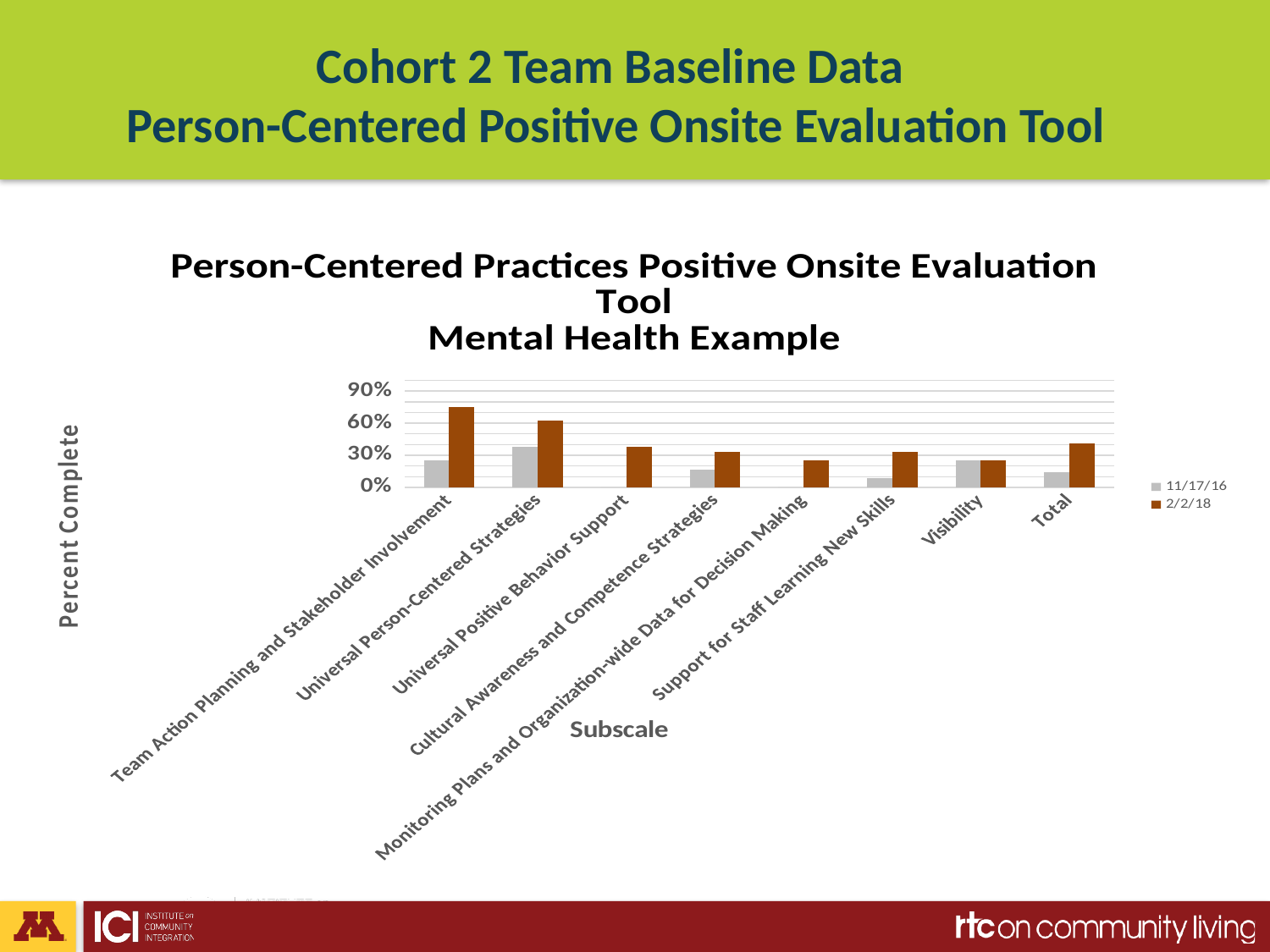
How many series does the legend list? 2 Is the 2/2/18 value for Visibility greater or less than 30%? less For Universal Person-Centered Strategies, which series has the larger value, 11/17/16 or 2/2/18? 2/2/18 Is the 2/2/18 value for Universal Person-Centered Strategies greater or less than 30%? greater For Total, which series has the larger value, 11/17/16 or 2/2/18? 2/2/18 How many subscale categories are shown on the x axis? 8 Is the 2/2/18 value for Team Action Planning and Stakeholder Involvement greater or less than 60%? greater What are the two series names listed in the legend? 11/17/16 and 2/2/18 What kind of chart is shown on the slide? bar chart What is the label of the y axis? Percent Complete Which subscale has the highest value for the 2/2/18 series? Team Action Planning and Stakeholder Involvement